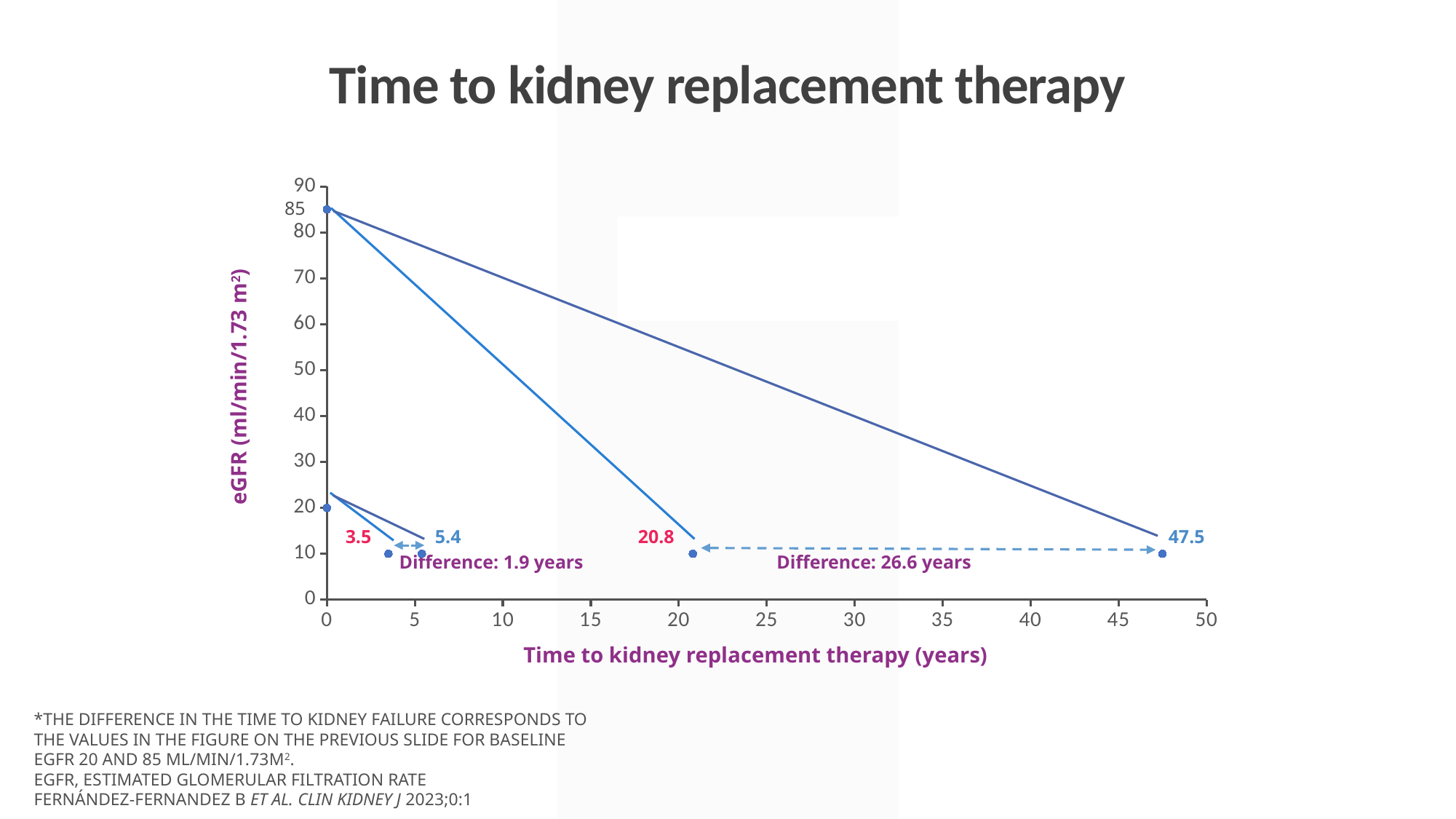
What is the title of the chart? Time to kidney replacement therapy Is the time value 47.5 greater or less than 45 on the x axis? greater What kind of chart is shown on the slide? line chart What is the shortest time to kidney replacement therapy labelled on the chart? 3.5 How many time-to-kidney-replacement-therapy values are labelled on the chart? 4 What difference in years is labelled between the 3.5 and 5.4 points? 1.9 years What is the label of the y axis? eGFR (ml/min/1.73 m²) Which is larger, the time value 5.4 or the time value 20.8? 20.8 What difference in years is labelled between the 20.8 and 47.5 points? 26.6 years What is the difference between the largest labelled time value (47.5) and the smallest (3.5)? 44 What is the longest time to kidney replacement therapy labelled on the chart? 47.5 Do the plotted lines rise or fall as time to kidney replacement therapy increases? fall